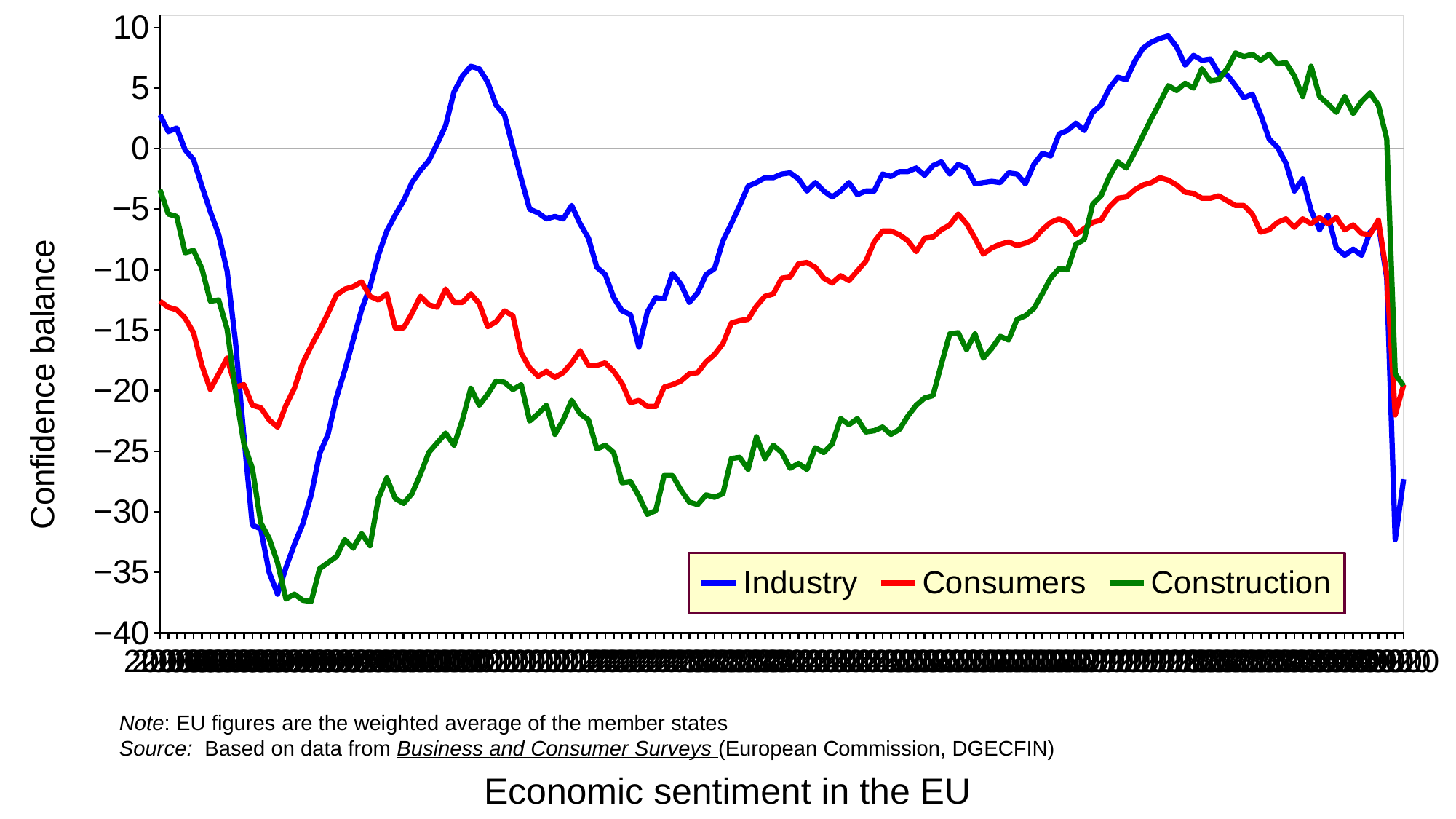
What kind of chart is shown on the slide? Line chart Which series has the highest minimum value, i.e. never drops as low as the other two? Consumers Is the highest value reached by the Industry line greater or less than 5? greater Is the lowest value reached by the Consumers line greater or less than -25? greater Is the lowest value reached by the Industry line greater or less than -30? less What colour is the Consumers line? Red How many series does the legend list? 3 Which series never rises above 0 on the chart? Consumers Which series reaches the highest value anywhere on the chart? Industry What is the title of the chart? Economic sentiment in the EU